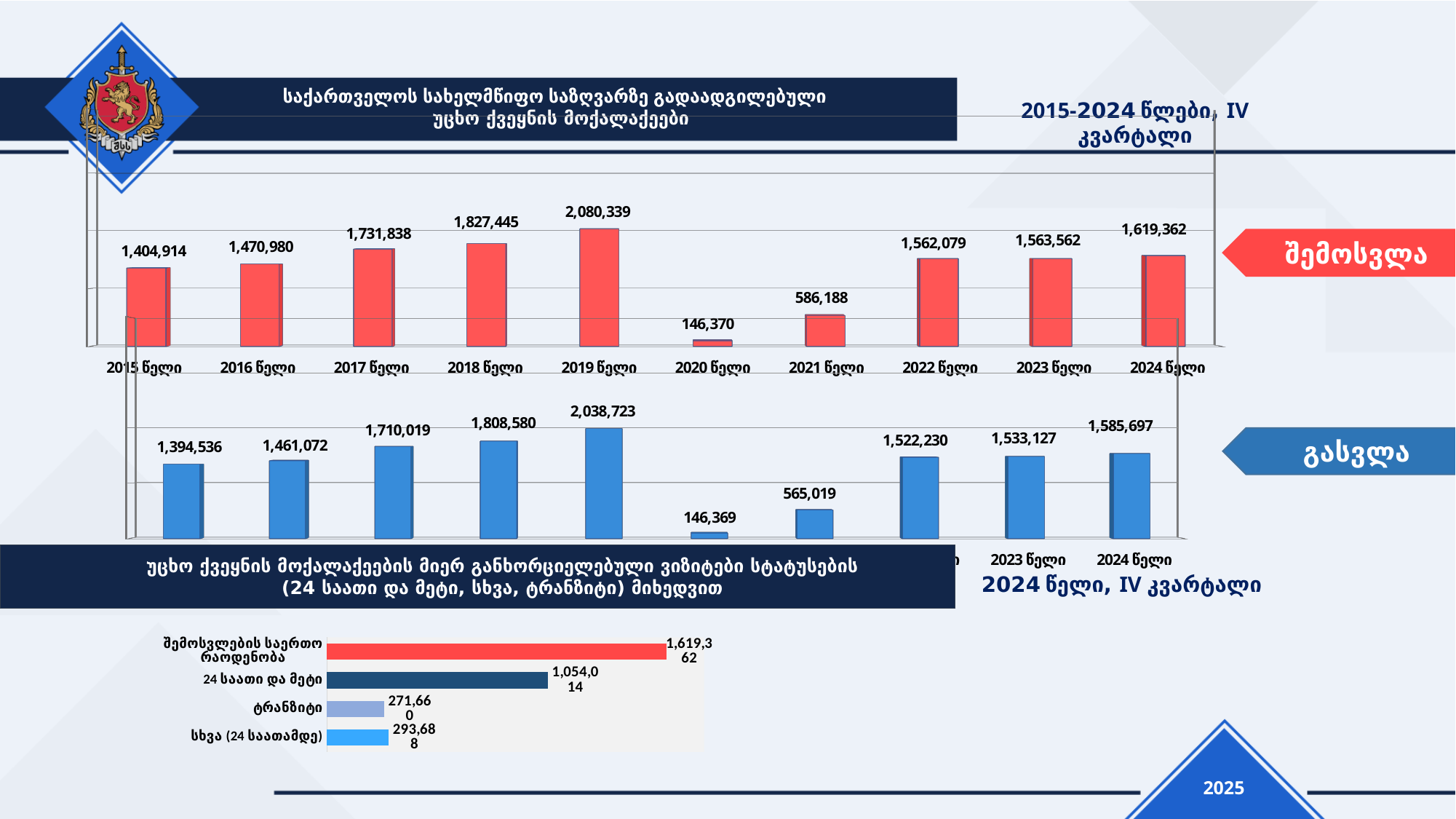
How many years are shown in the top (red) bar chart? 10 In the bottom horizontal bar chart, what is the value for 24 საათი და მეტი? 1,054,014 In the top (red) bar chart, which year has the lowest value? 2020 წელი In the bottom horizontal bar chart, what is the value for ტრანზიტი? 271,660 In the top (red) bar chart, do the values rise or fall from 2015 წელი to 2019 წელი? rise What type of chart is the bottom chart on the slide? bar chart In the top (red) bar chart, what is the value for 2019 წელი? 2,080,339 In the middle (blue) bar chart, which year has the highest value? 2019 წელი In the middle (blue) bar chart, what is the value for 2021 წელი? 565,019 In the middle (blue) bar chart, is the value for 2017 წელი larger or smaller than the value for 2018 წელი? smaller In the top (red) bar chart, what is the difference between the values for 2024 წელი and 2023 წელი? 55,800 In the top (red) bar chart, which year has the highest value? 2019 წელი